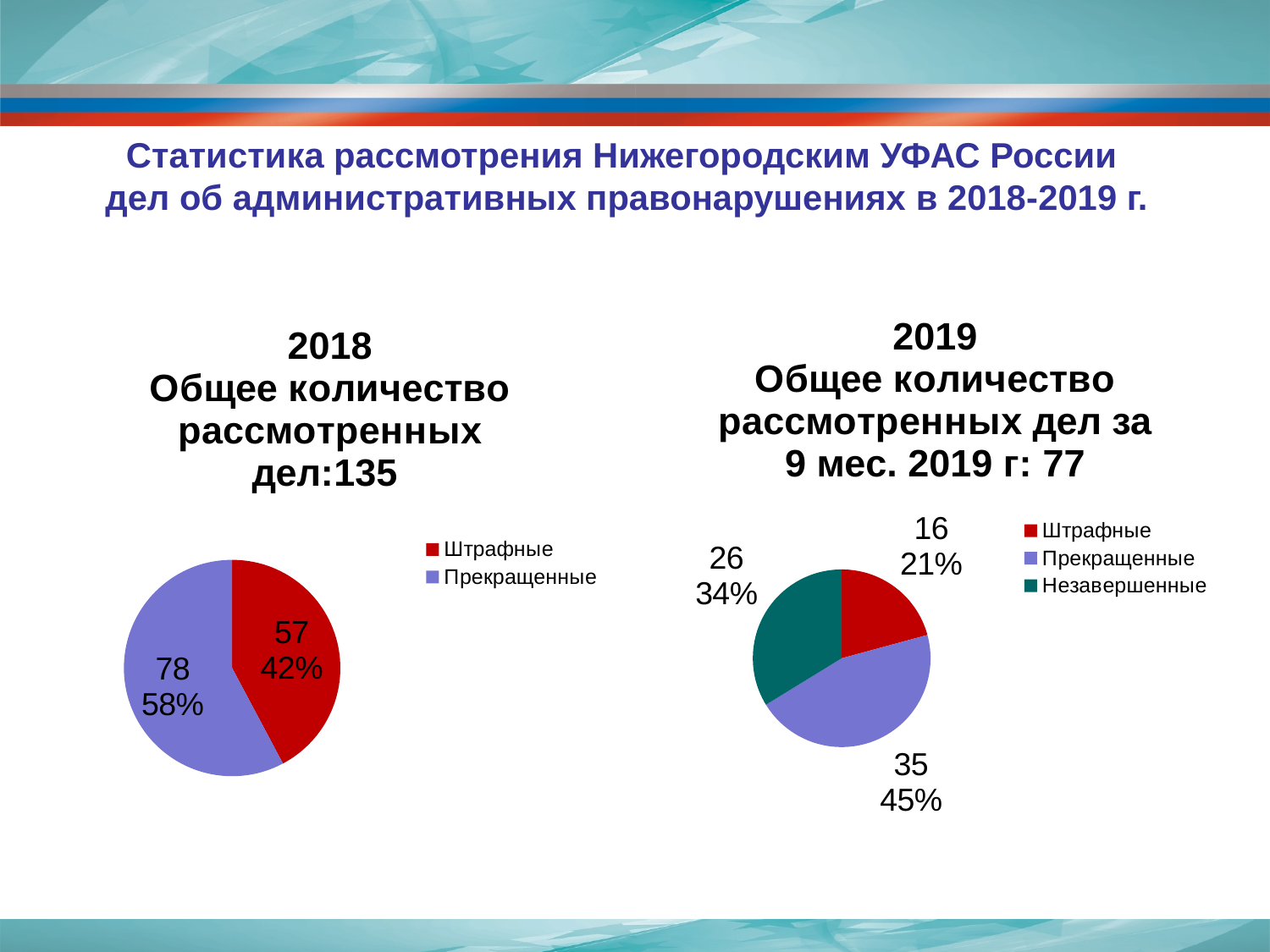
In the 2018 pie chart, how many cases are labelled Штрафные? 57 In the 2019 pie chart, which category has the smallest slice? Штрафные In the 2018 pie chart, which is larger, Штрафные or Прекращенные? Прекращенные In the 2019 pie chart, what percentage share does the Штрафные slice have? 21% In the 2019 pie chart, which category has the largest slice? Прекращенные In the 2018 pie chart, what is the difference between the Прекращенные and Штрафные counts? 21 In the 2018 pie chart, what percentage share does the Прекращенные slice have? 58% In the 2019 pie chart, how many cases are labelled Незавершенные? 26 What type of chart is used for the 2018 data? Pie chart In the 2019 pie chart, what colour is the Незавершенные slice? Dark green (teal) How many categories does the legend of the 2019 pie chart list? 3 In the 2019 pie chart, what is the difference between the Прекращенные and Незавершенные counts? 9